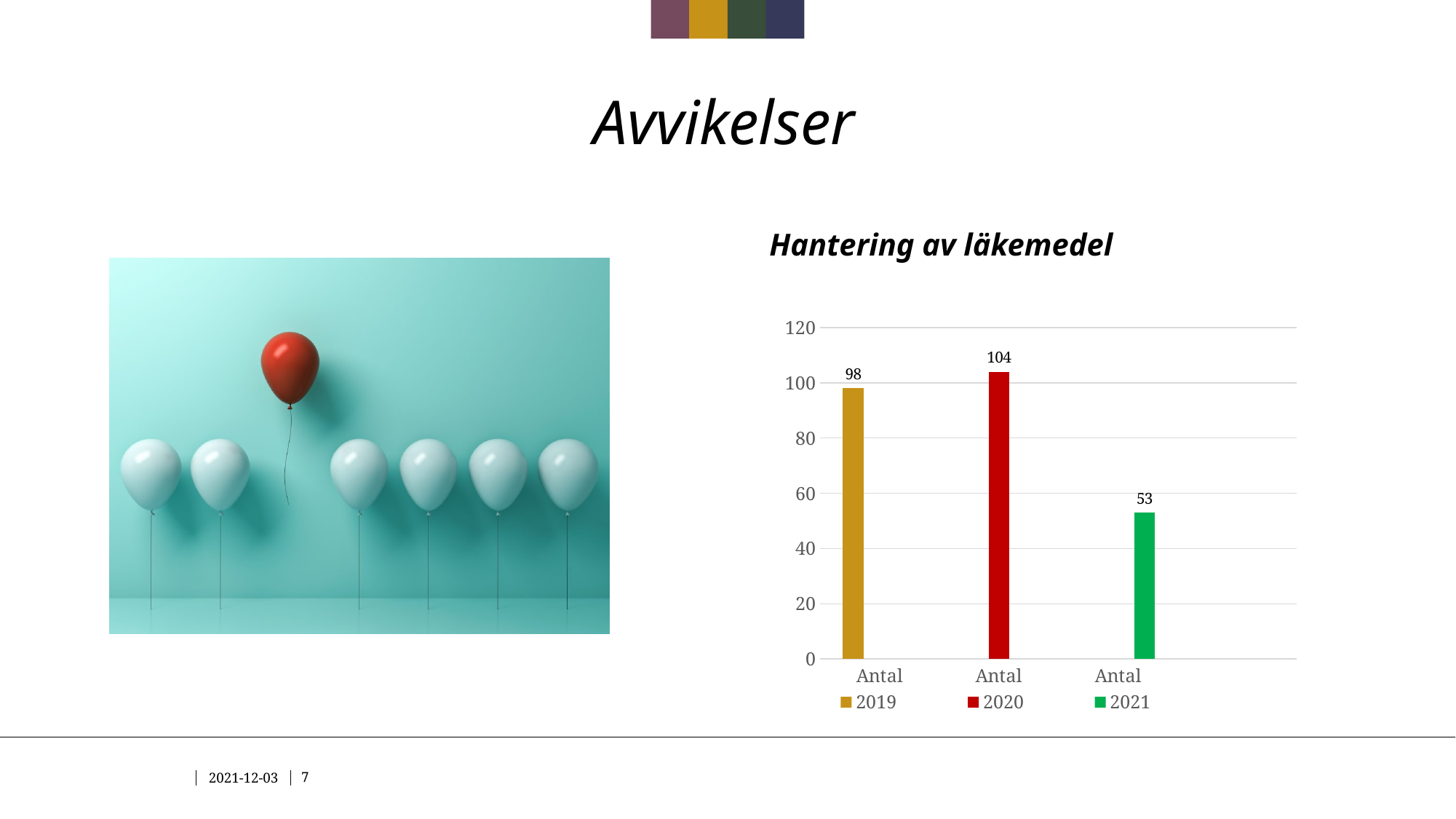
What is the value for 2020 in the Hantering av läkemedel chart? 104 How many series does the legend of the Hantering av läkemedel chart list? 3 What is the difference between the 2020 and 2021 values in the Hantering av läkemedel chart? 51 Which is larger in the Hantering av läkemedel chart, the value for 2019 or the value for 2021? 2019 What colour is the bar for 2020 in the Hantering av läkemedel chart? red What kind of chart is the Hantering av läkemedel chart? bar chart What is the difference between the 2020 and 2019 values in the Hantering av läkemedel chart? 6 What is the value for 2021 in the Hantering av läkemedel chart? 53 What is the value for 2019 in the Hantering av läkemedel chart? 98 Which year has the highest value in the Hantering av läkemedel chart? 2020 Is the value for 2021 in the Hantering av läkemedel chart greater or less than 60? less Which year has the lowest value in the Hantering av läkemedel chart? 2021